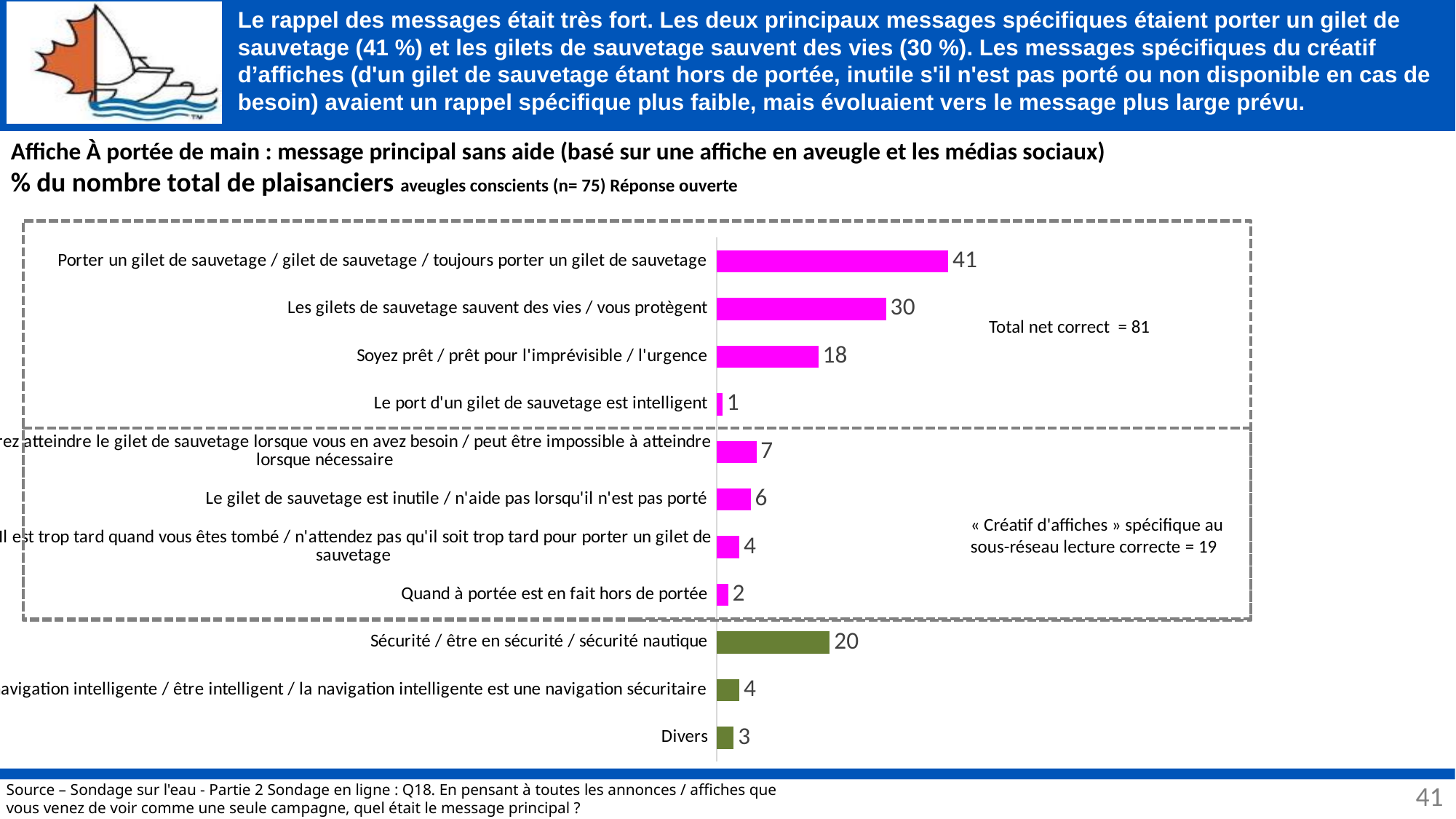
Which category has the lowest value in the chart? Le port d'un gilet de sauvetage est intelligent Which category has the highest value in the chart? Porter un gilet de sauvetage / gilet de sauvetage / toujours porter un gilet de sauvetage What is the value for "Sécurité / être en sécurité / sécurité nautique"? 20 What kind of chart is shown on the slide? Bar chart Which is larger: the value for "Soyez prêt / prêt pour l'imprévisible / l'urgence" or the value for "Sécurité / être en sécurité / sécurité nautique"? Sécurité / être en sécurité / sécurité nautique What is the value for "Les gilets de sauvetage sauvent des vies / vous protègent"? 30 How many categories are plotted in the chart? 11 What is the value for "Soyez prêt / prêt pour l'imprévisible / l'urgence"? 18 What is the value for "Divers"? 3 What is the value for "Quand à portée est en fait hors de portée"? 2 What is the value for "Porter un gilet de sauvetage / gilet de sauvetage / toujours porter un gilet de sauvetage"? 41 What is the difference between the values for "Porter un gilet de sauvetage / gilet de sauvetage / toujours porter un gilet de sauvetage" and "Les gilets de sauvetage sauvent des vies / vous protègent"? 11